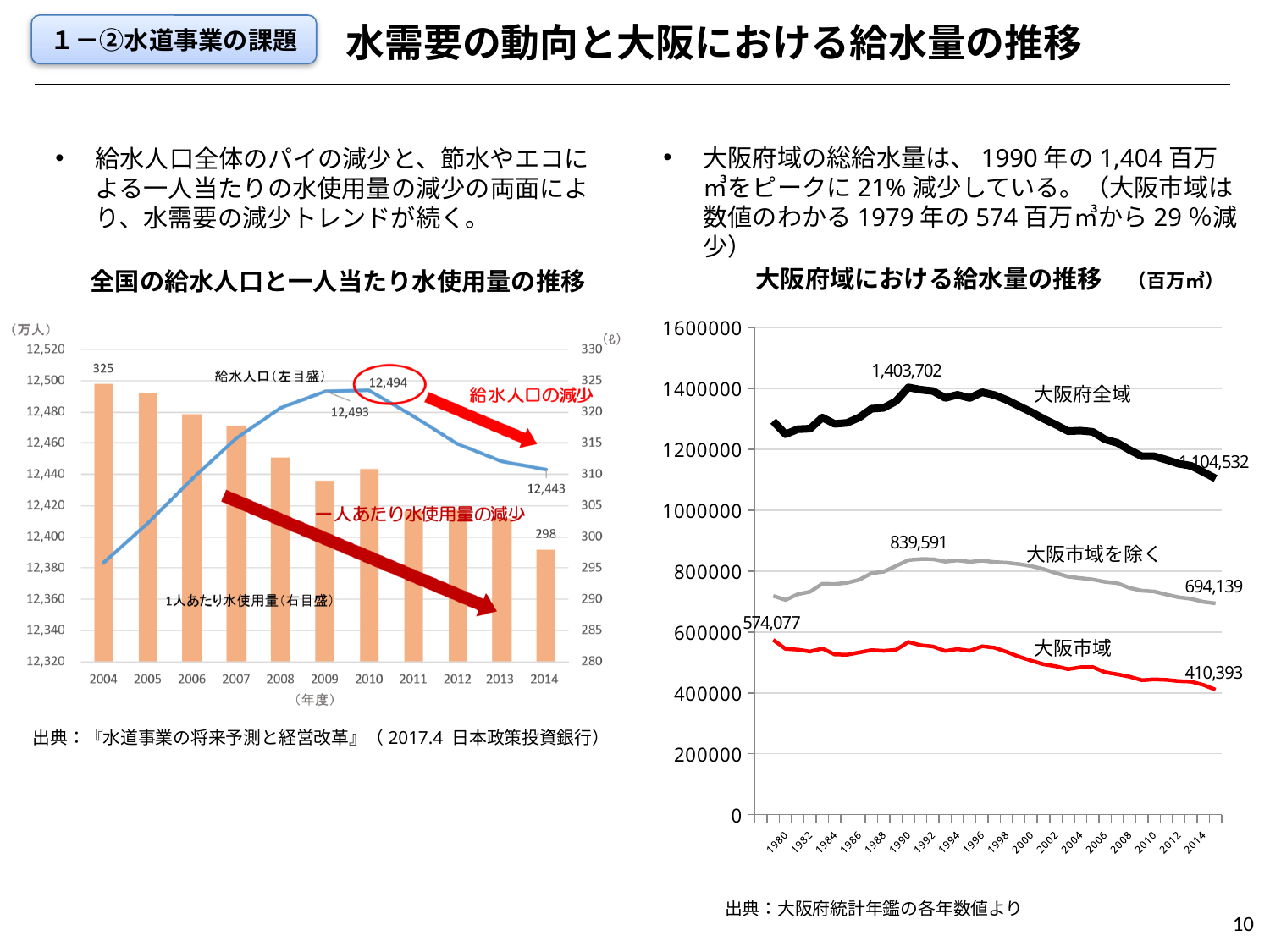
In the right chart (大阪府域における給水量の推移), what is the difference between the peak value 1,403,702 and the final value 1,104,532 of the 大阪府全域 line? 299,170 In the right chart (大阪府域における給水量の推移), is the value of the 大阪市域を除く line in 1980 greater or less than 800000? less In the left chart (全国の給水人口と一人当たり水使用量の推移), what is the difference between the 2004 bar value (325) and the 2014 bar value (298)? 27 In the right chart (大阪府域における給水量の推移), what is the final value labelled on the 大阪市域を除く line? 694,139 In the left chart (全国の給水人口と一人当たり水使用量の推移), what is the value labelled on the 2004 bar? 325 In the right chart (大阪府域における給水量の推移), what is the final value labelled on the 大阪市域 line? 410,393 In the right chart (大阪府域における給水量の推移), what kind of chart is it? Line chart In the right chart (大阪府域における給水量の推移), which is larger at the end of the series: 大阪市域を除く (694,139) or 大阪市域 (410,393)? 大阪市域を除く In the right chart (大阪府域における給水量の推移), what is the peak value labelled on the 大阪府全域 line? 1,403,702 In the left chart (全国の給水人口と一人当たり水使用量の推移), how many years are shown on the x axis? 11 In the right chart (大阪府域における給水量の推移), how many series are plotted? 3 In the left chart (全国の給水人口と一人当たり水使用量の推移), what is the 給水人口 value labelled for 2014? 12,443